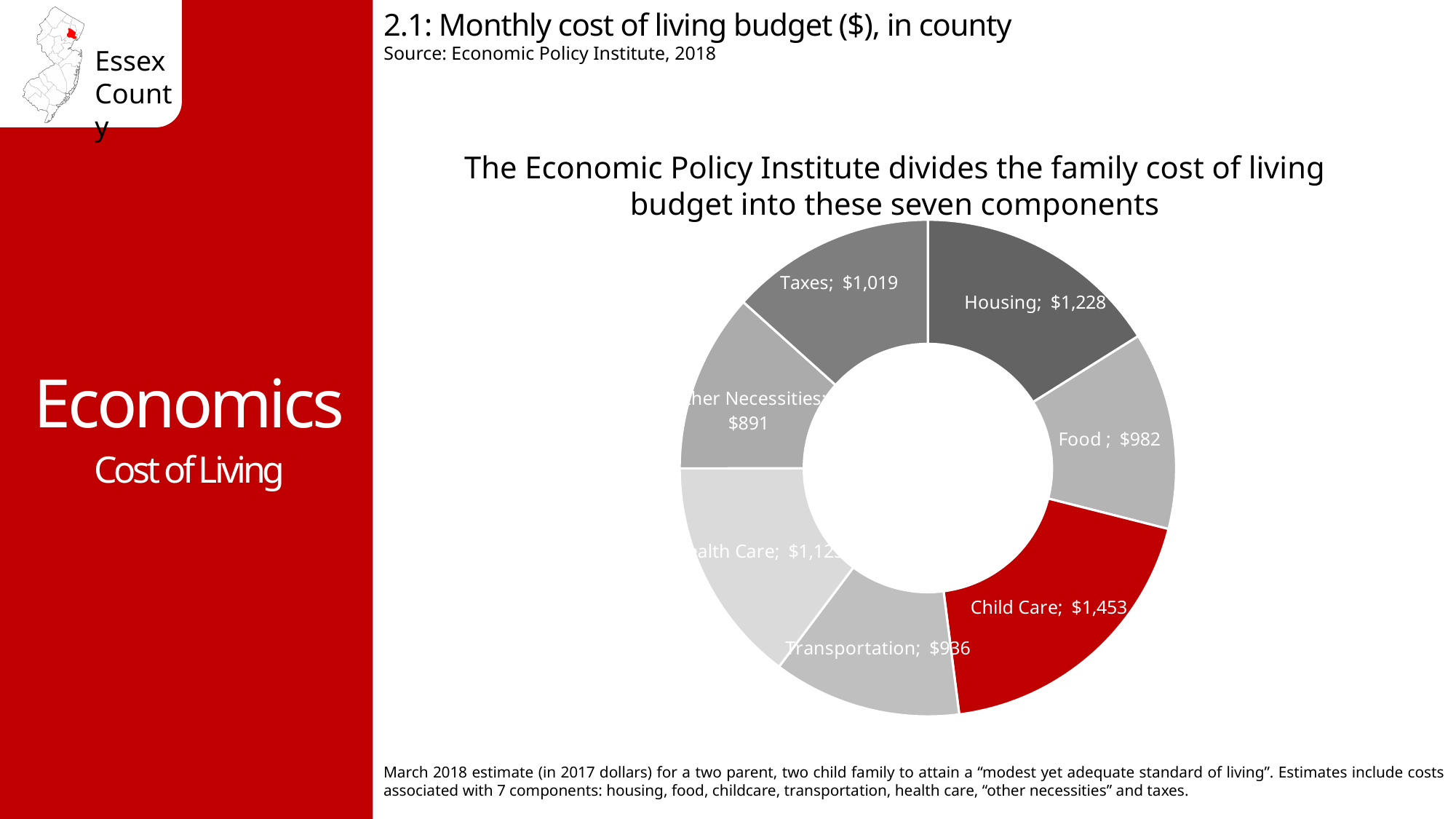
What type of chart is shown on the slide? Doughnut (pie) chart What is the difference between the Housing cost and the Taxes cost? $209 What is the monthly cost for Housing in the chart? $1,228 What is the monthly cost for Taxes in the chart? $1,019 What is the monthly cost for Food in the chart? $982 What is the monthly cost for Child Care in the chart? $1,453 Which component has the highest monthly cost in the chart? Child Care What is the difference between the Child Care cost and the Housing cost? $225 What is the monthly cost for Other Necessities in the chart? $891 Which is larger, the Housing cost or the Food cost? Housing How many components are shown in the chart? 7 Which component has the lowest monthly cost in the chart? Other Necessities